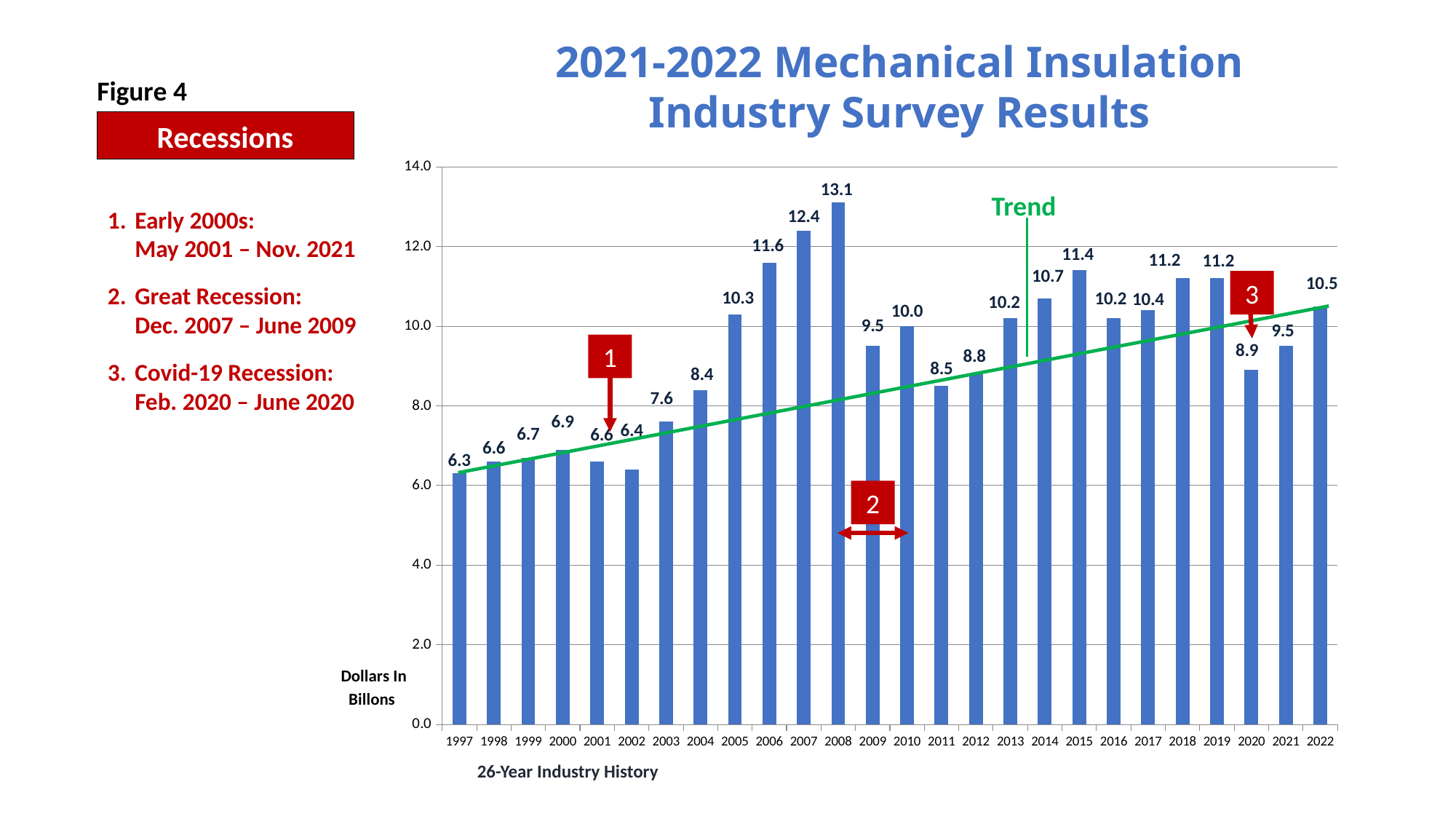
How many years are shown on the x axis? 26 What is the value for 2020? 8.9 What is the difference between the values for 2008 and 2009? 3.6 Which year has the lowest value? 1997 What is the value for 2008? 13.1 What kind of chart is this? bar chart What is the title of the chart? 2021-2022 Mechanical Insulation Industry Survey Results Which year has the highest value? 2008 Do the values generally rise or fall from 1997 to 2022 according to the trend line? rise Which is larger, the value for 2015 or the value for 2016? 2015 What unit is given for the y axis? Dollars In Billons What is the value for 1997? 6.3